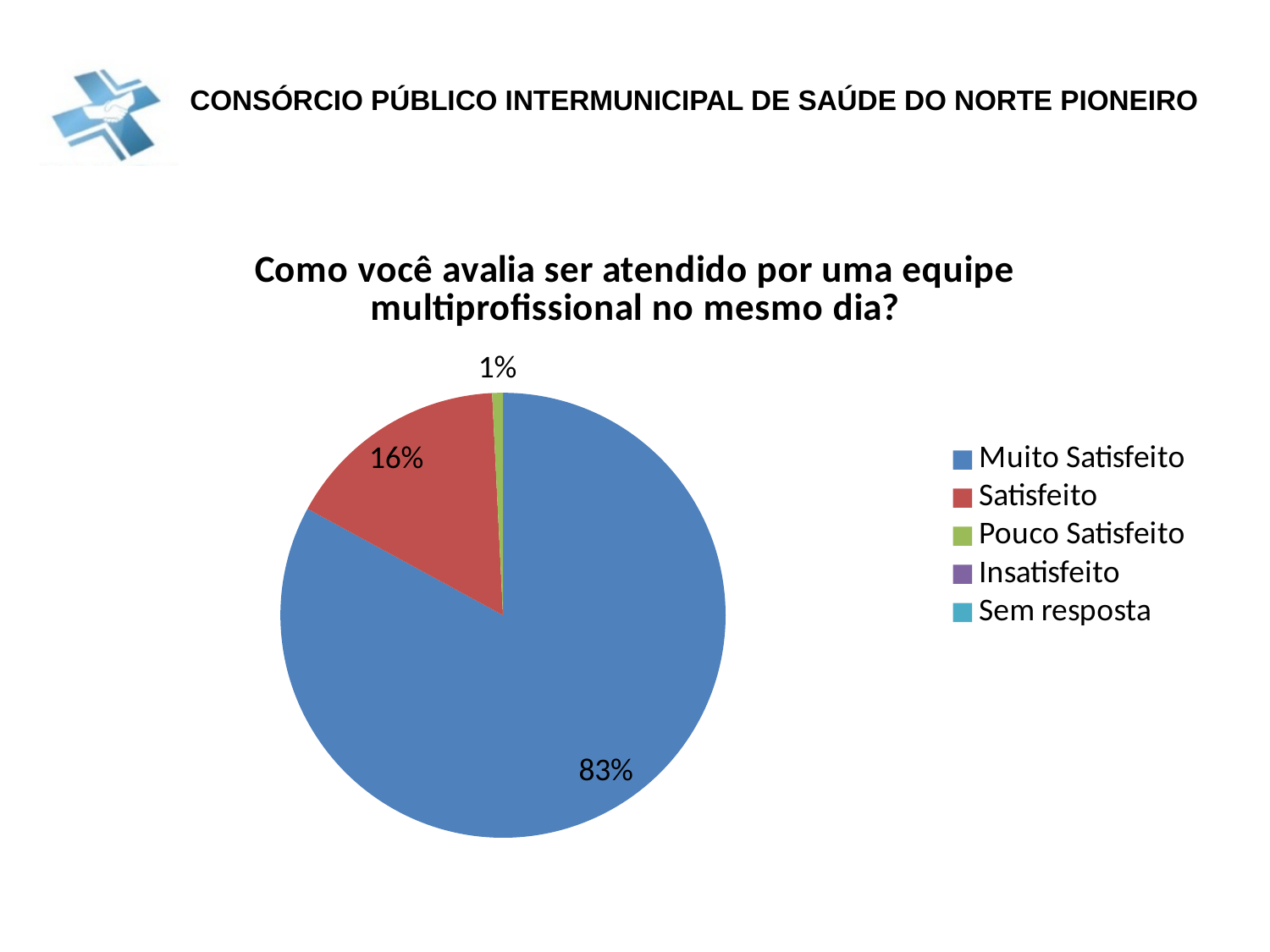
What share of the pie is labelled for Muito Satisfeito? 83% What share of the pie is labelled for Satisfeito? 16% What is the difference in percentage points between the Muito Satisfeito and Satisfeito slices? 67 How many entries does the legend list? 5 What is the combined share of the Muito Satisfeito and Satisfeito slices? 99% Which slice is larger, Satisfeito or Pouco Satisfeito? Satisfeito What colour is the Satisfeito slice? red What is the title of the chart? Como você avalia ser atendido por uma equipe multiprofissional no mesmo dia? Which of the labelled slices is the smallest? Pouco Satisfeito What kind of chart is shown on the slide? pie chart What share of the pie is labelled for Pouco Satisfeito? 1% Which category has the largest slice of the pie? Muito Satisfeito